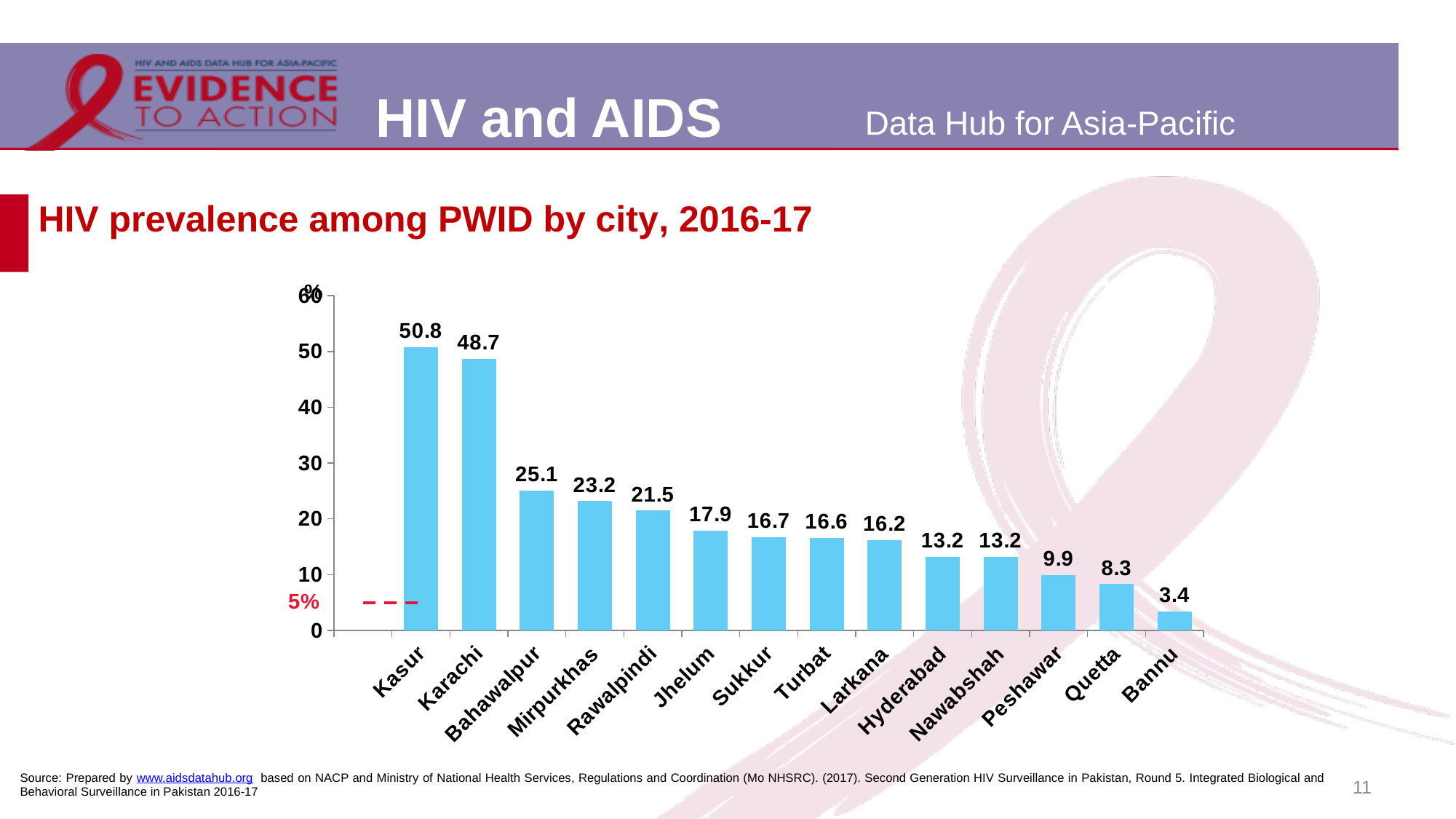
What reference level is marked by the red dashed line on the chart? 5% Which city has the highest HIV prevalence among PWID? Kasur Which city has a higher HIV prevalence among PWID, Jhelum or Larkana? Jhelum What is the HIV prevalence among PWID in Peshawar? 9.9 What is the HIV prevalence among PWID in Karachi? 48.7 What kind of chart is used to show HIV prevalence among PWID by city? Bar chart What is the HIV prevalence among PWID in Rawalpindi? 21.5 Which city has the lowest HIV prevalence among PWID? Bannu What is the difference in HIV prevalence between Kasur and Karachi? 2.1 What is the difference in HIV prevalence between Bahawalpur and Quetta? 16.8 How many cities are shown in the chart? 14 Is the value for Mirpurkhas greater or less than 20? greater